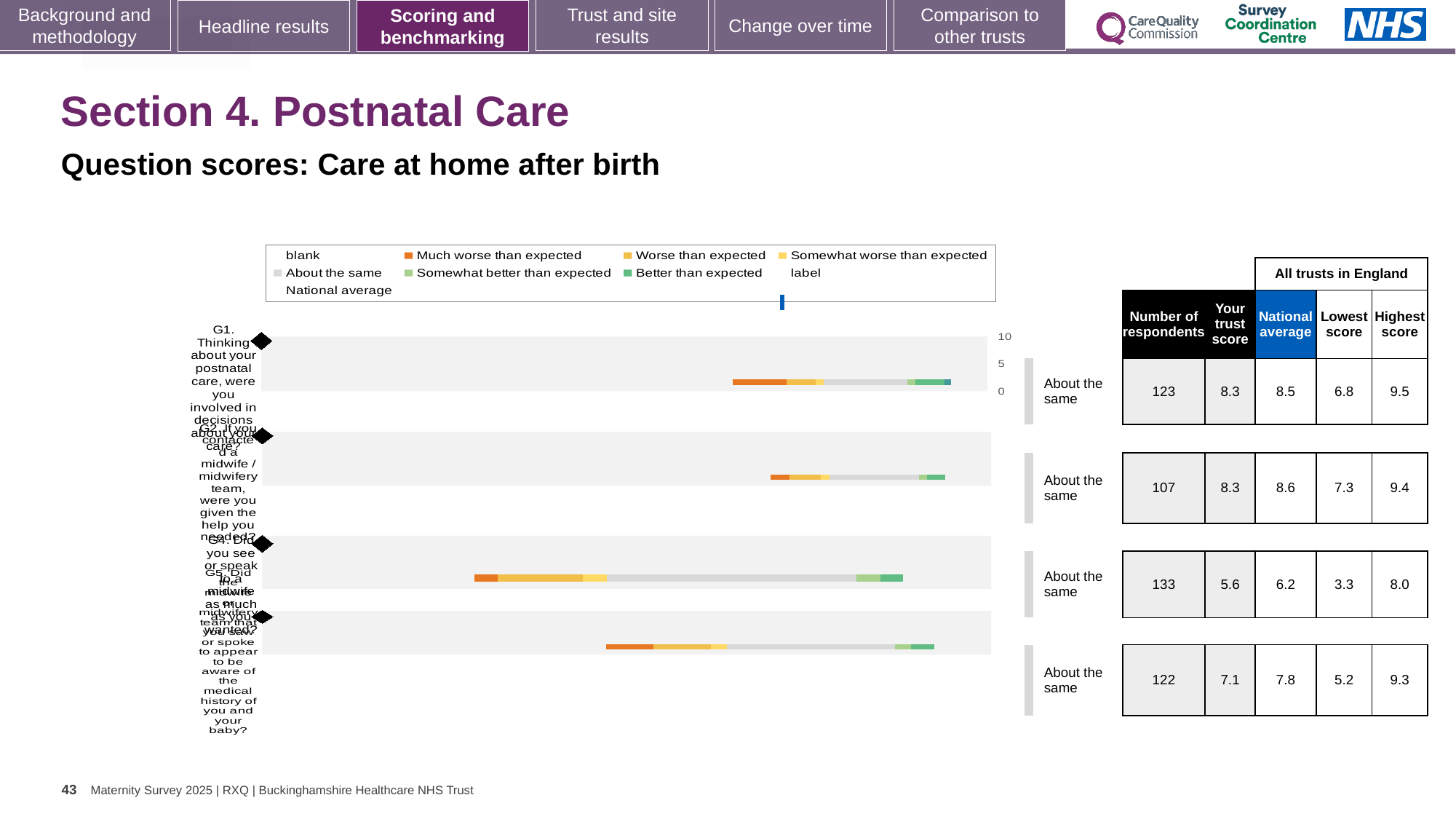
In the table beside the chart, what is the national average for question G2? 8.6 Which question row has the lowest trust score in the table beside the chart? the third row (5.6) What kind of chart is shown on the slide? bar chart In the table beside the chart, what is the lowest score for the third question row? 3.3 What is the difference between the national average and the trust score for question G1? 0.2 In the table beside the chart, what is the number of respondents for question G1? 123 Is the trust score for question G2 larger or smaller than the trust score for the fourth question row? larger In the table beside the chart, what is the trust score for question G1? 8.3 How many question bars are plotted in the chart? 4 Which question row has the highest number of respondents in the table beside the chart? the third row (133) What benchmark category is shown next to each question bar in the chart? About the same In the table beside the chart, what is the highest score for the fourth question row? 9.3